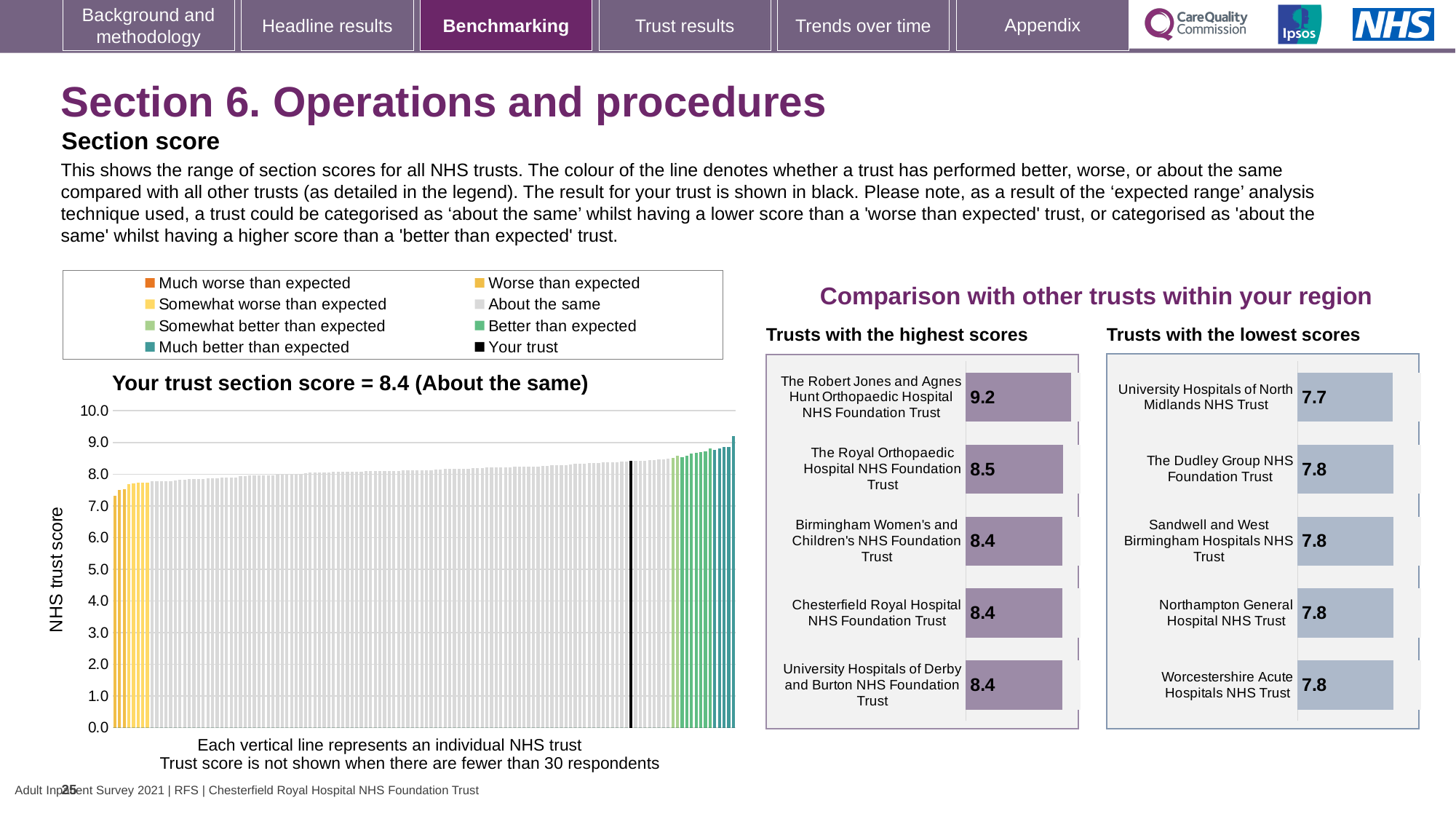
In the 'Your trust section score' chart, do the bar heights rise or fall from left to right? rise What kind of chart is the 'Your trust section score' chart? bar chart In the 'Your trust section score' chart, what is the section score for your trust? 8.4 In the 'Trusts with the lowest scores' chart, which trust has the lowest score? University Hospitals of North Midlands NHS Trust In the 'Trusts with the lowest scores' chart, what is the difference between the scores of The Dudley Group NHS Foundation Trust and University Hospitals of North Midlands NHS Trust? 0.1 In the 'Trusts with the highest scores' chart, what is the score for The Robert Jones and Agnes Hunt Orthopaedic Hospital NHS Foundation Trust? 9.2 In the 'Trusts with the highest scores' chart, which trust has the highest score? The Robert Jones and Agnes Hunt Orthopaedic Hospital NHS Foundation Trust In the 'Trusts with the lowest scores' chart, what is the score for University Hospitals of North Midlands NHS Trust? 7.7 In the 'Trusts with the highest scores' chart, what is the score for The Royal Orthopaedic Hospital NHS Foundation Trust? 8.5 In the 'Trusts with the highest scores' chart, how many trusts are shown? 5 In the 'Trusts with the highest scores' chart, what is the difference between the scores of The Robert Jones and Agnes Hunt Orthopaedic Hospital NHS Foundation Trust and The Royal Orthopaedic Hospital NHS Foundation Trust? 0.7 In the 'Trusts with the lowest scores' chart, which is larger: the score for Worcestershire Acute Hospitals NHS Trust or University Hospitals of North Midlands NHS Trust? Worcestershire Acute Hospitals NHS Trust